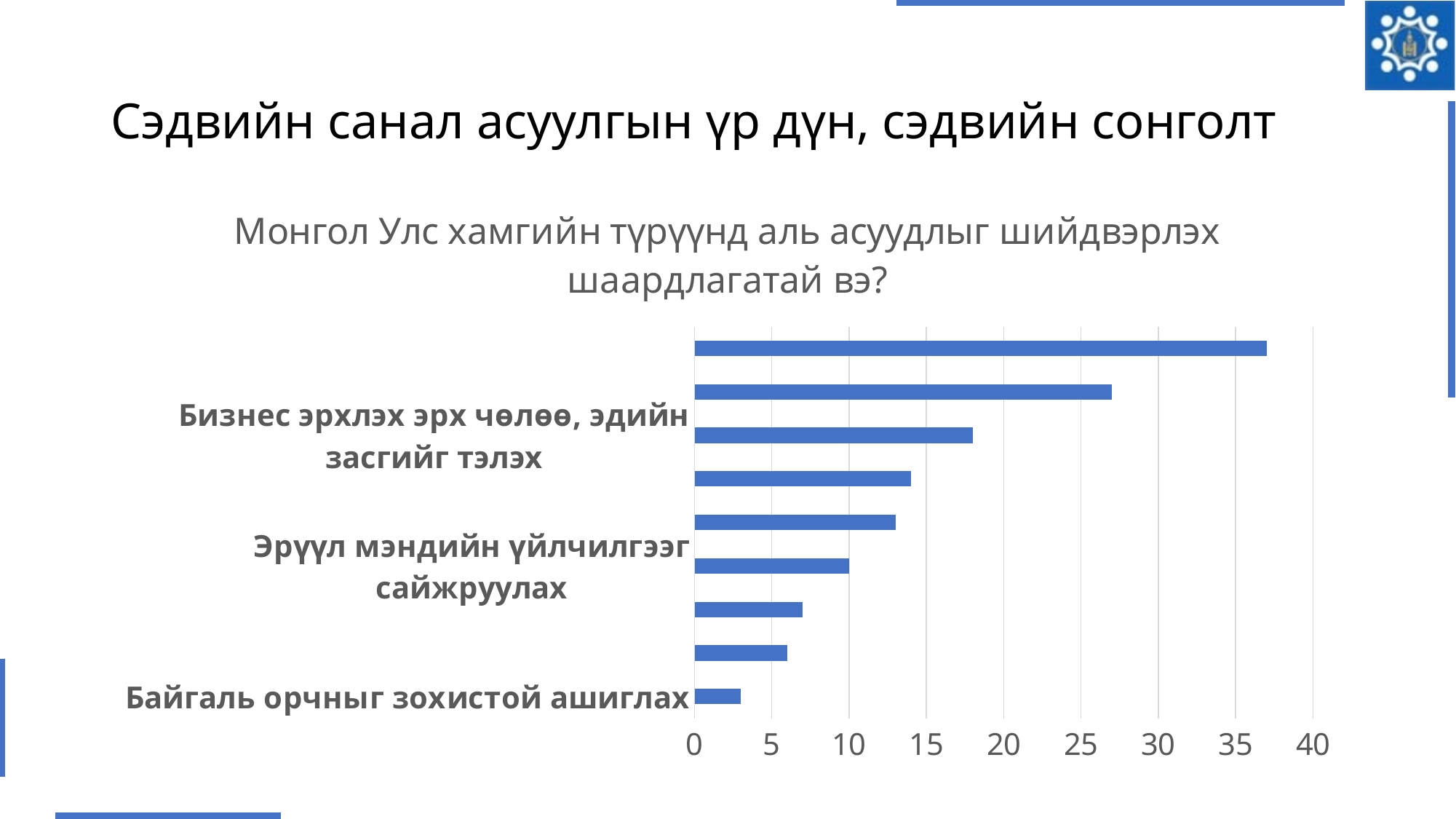
Which has the larger value: Эрүүл мэндийн үйлчилгээг сайжруулах or Бизнес эрхлэх эрх чөлөө, эдийн засгийг тэлэх? Бизнес эрхлэх эрх чөлөө, эдийн засгийг тэлэх Is the value for Эрүүл мэндийн үйлчилгээг сайжруулах greater or less than 15? less What is the title of the chart? Монгол Улс хамгийн түрүүнд аль асуудлыг шийдвэрлэх шаардлагатай вэ? What kind of chart is shown on the slide? bar chart Which labelled category has the lowest value in the chart? Байгаль орчныг зохистой ашиглах Which has the larger value: Бизнес эрхлэх эрх чөлөө, эдийн засгийг тэлэх or Байгаль орчныг зохистой ашиглах? Бизнес эрхлэх эрх чөлөө, эдийн засгийг тэлэх Is the value for Байгаль орчныг зохистой ашиглах greater or less than 5? less Is the value for Бизнес эрхлэх эрх чөлөө, эдийн засгийг тэлэх greater or less than 20? less Do the bar values increase or decrease going from the top bar to the bottom bar? decrease How many bars does the chart contain? 9